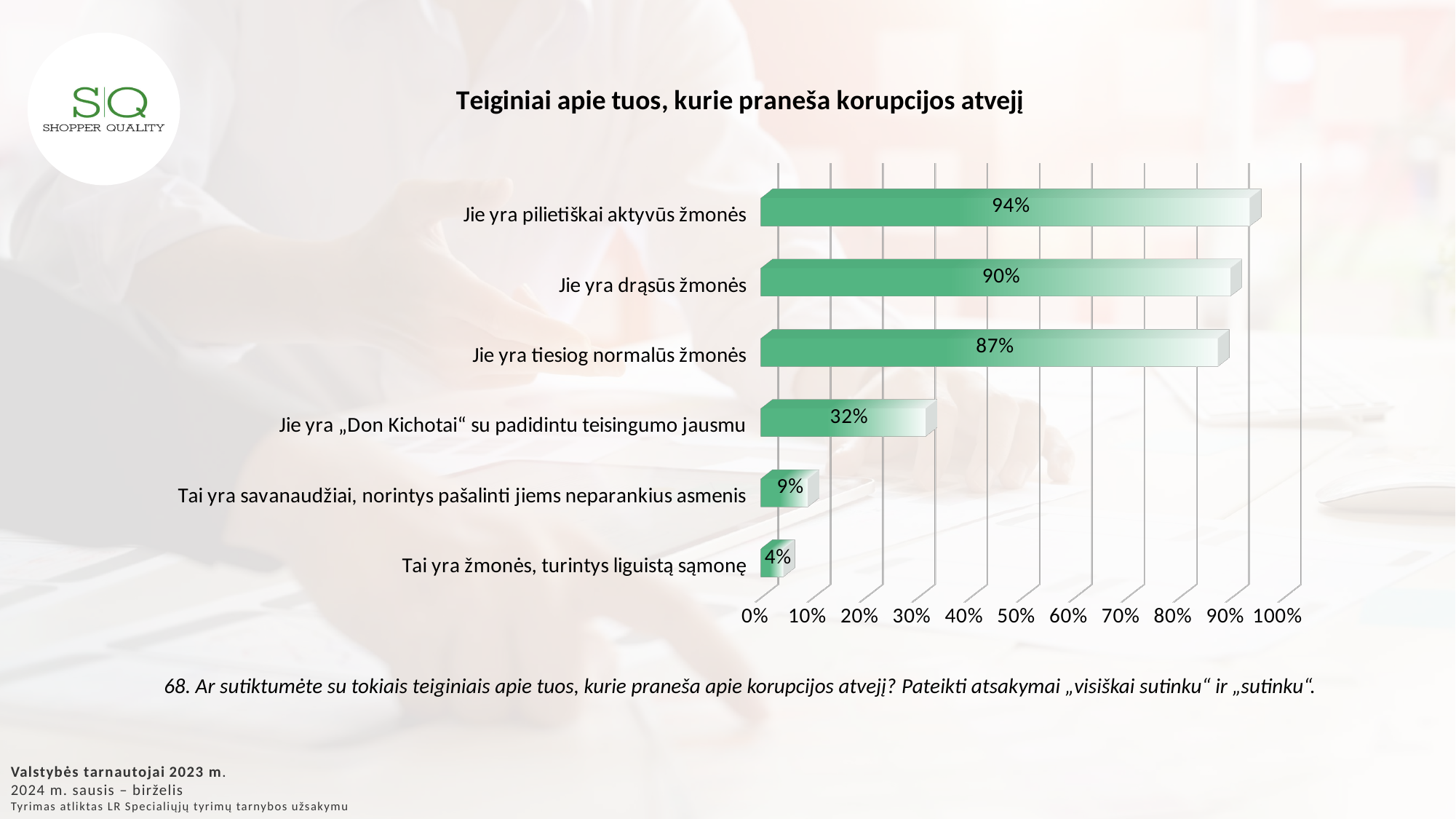
What is the value for "Tai yra žmonės, turintys liguistą sąmonę"? 4% What is the value for "Jie yra drąsūs žmonės"? 90% What is the value for "Jie yra pilietiškai aktyvūs žmonės"? 94% What is the title of the chart? Teiginiai apie tuos, kurie praneša korupcijos atvejį Is the value for "Tai yra savanaudžiai, norintys pašalinti jiems neparankius asmenis" greater or less than 20%? less What kind of chart is shown on the slide? bar chart Which category has the highest value? Jie yra pilietiškai aktyvūs žmonės What is the difference between the values for "Jie yra pilietiškai aktyvūs žmonės" and "Jie yra tiesiog normalūs žmonės"? 7% How many categories are shown in the chart? 6 What is the value for "Jie yra „Don Kichotai“ su padidintu teisingumo jausmu"? 32% Which category has the lowest value? Tai yra žmonės, turintys liguistą sąmonę Which is larger: the value for "Jie yra drąsūs žmonės" or for "Jie yra „Don Kichotai“ su padidintu teisingumo jausmu"? Jie yra drąsūs žmonės